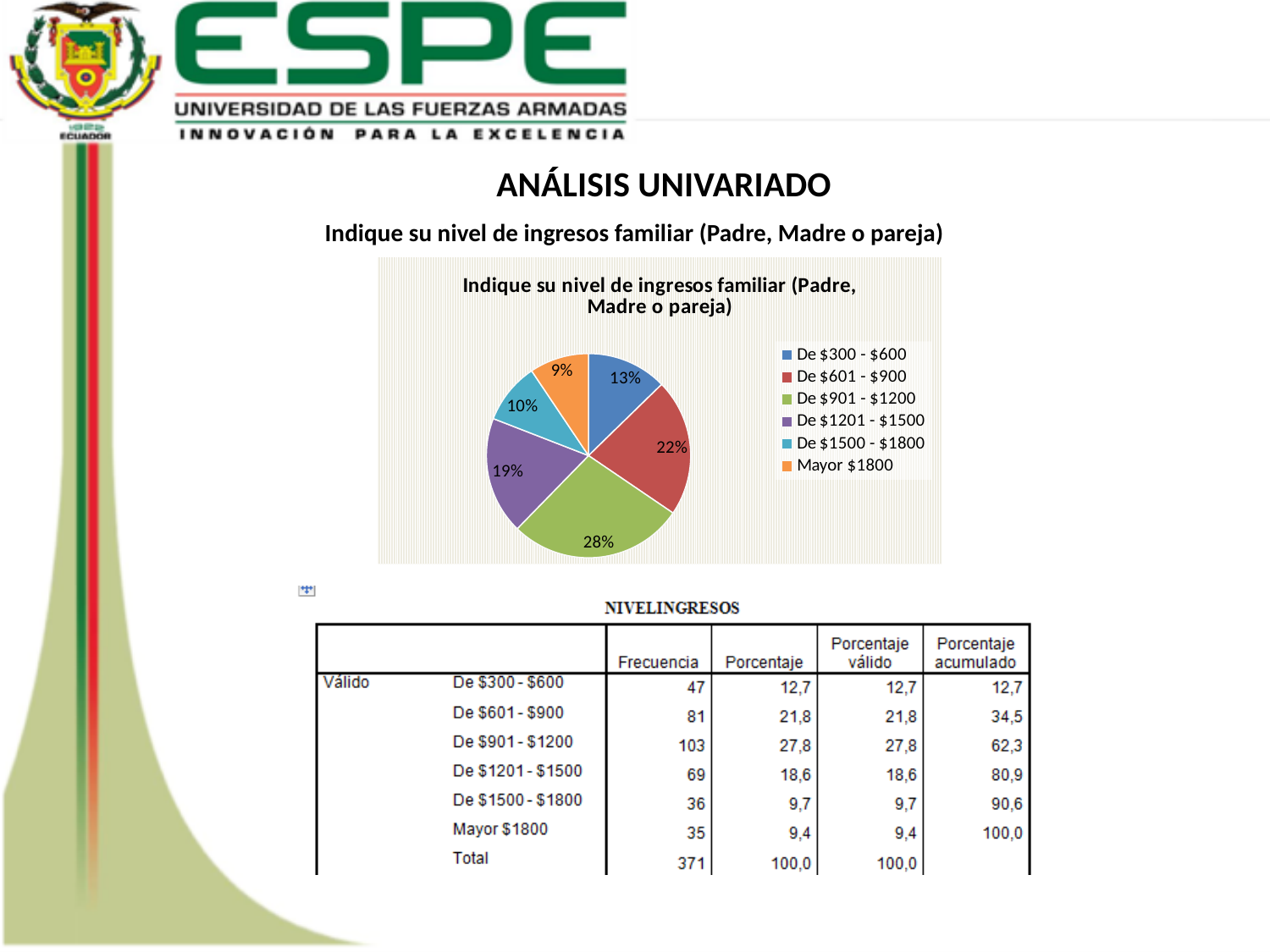
Which category has the largest share of the pie? De $901 - $1200 Which slice is larger: De $601 - $900 or De $1201 - $1500? De $601 - $900 What is the difference in percentage points between the De $601 - $900 slice and the De $1500 - $1800 slice? 12 What percentage of the pie corresponds to the category De $300 - $600? 13% How many entries does the legend list? 6 What percentage of the pie corresponds to the category Mayor $1800? 9% How many categories does the pie chart have? 6 Which category has the smallest share of the pie? Mayor $1800 What percentage of the pie corresponds to the category De $901 - $1200? 28% What type of chart is shown on the slide? pie chart What percentage of the pie corresponds to the category De $1201 - $1500? 19% What colour is the slice for De $1500 - $1800? teal (light blue)